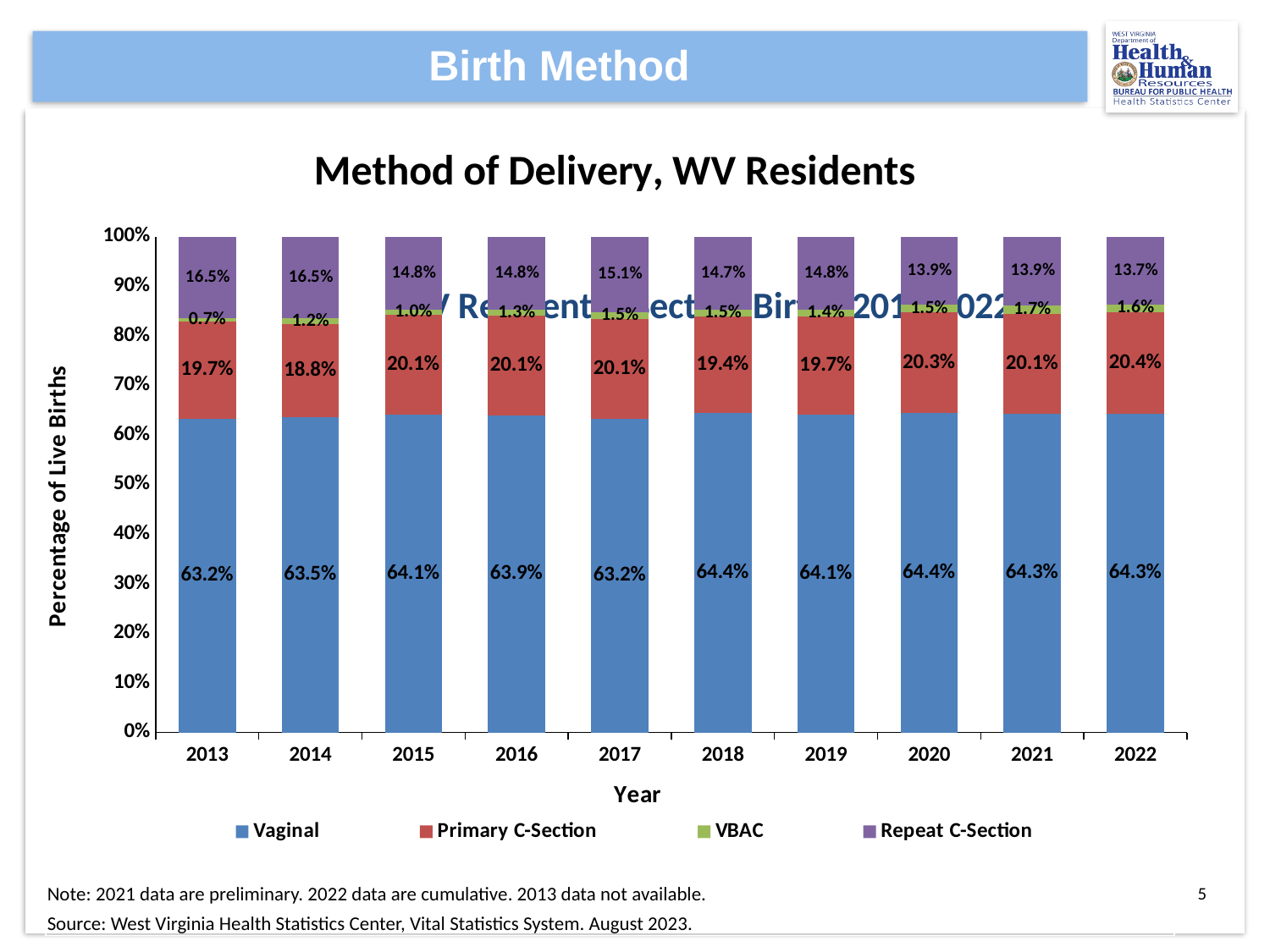
Which year has the larger Vaginal share, 2013 or 2014? 2014 In which year is the Primary C-Section percentage highest? 2022 What kind of chart is shown on the slide? Stacked bar chart How many series does the legend list? 4 In which year is the Repeat C-Section percentage lowest? 2022 Does the Repeat C-Section share generally rise or fall from 2013 to 2022? Fall What is the Primary C-Section percentage for 2022? 20.4% How many years are shown on the x axis? 10 By how many percentage points did the Repeat C-Section share fall from 2013 to 2022? 2.8 percentage points What percentage of live births were Repeat C-Sections in 2013? 16.5% What is the VBAC percentage in 2013? 0.7% What is the Vaginal share of live births in 2018? 64.4%